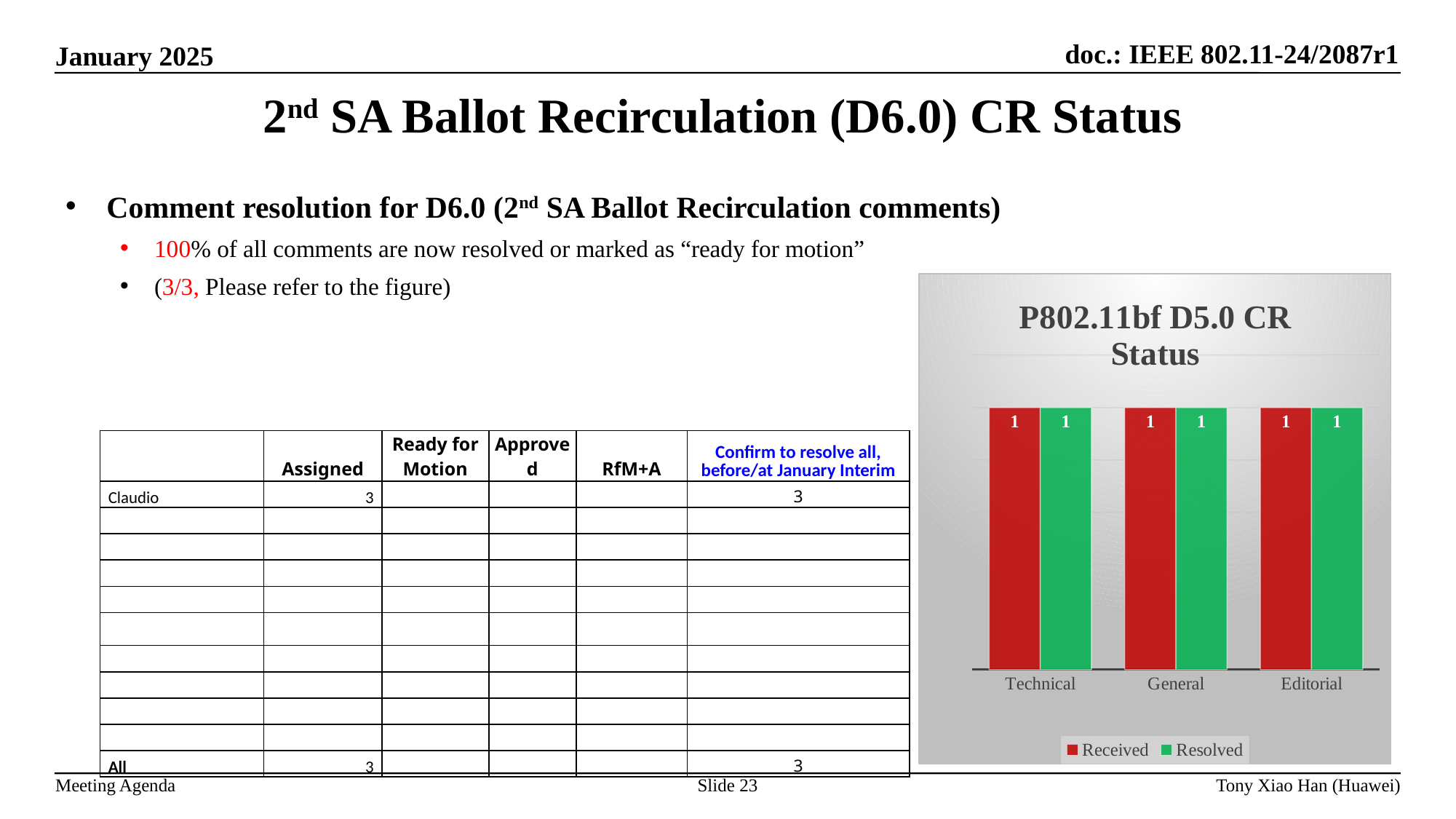
What is the difference between the Received value for Technical and the Received value for Editorial in the chart? 0 What kind of chart is shown on the slide? bar chart What is the Resolved value for Technical in the chart? 1 How many categories are shown on the x axis of the chart? 3 What is the Received value for General in the chart? 1 What is the Resolved value for Editorial in the chart? 1 What is the Received value for Technical in the chart? 1 What is the difference between the Received and Resolved values for General in the chart? 0 Which categories appear on the x axis of the chart? Technical, General, Editorial What are the series names listed in the chart legend? Received, Resolved What is the title of the chart on the slide? P802.11bf D5.0 CR Status How many series does the chart legend list? 2